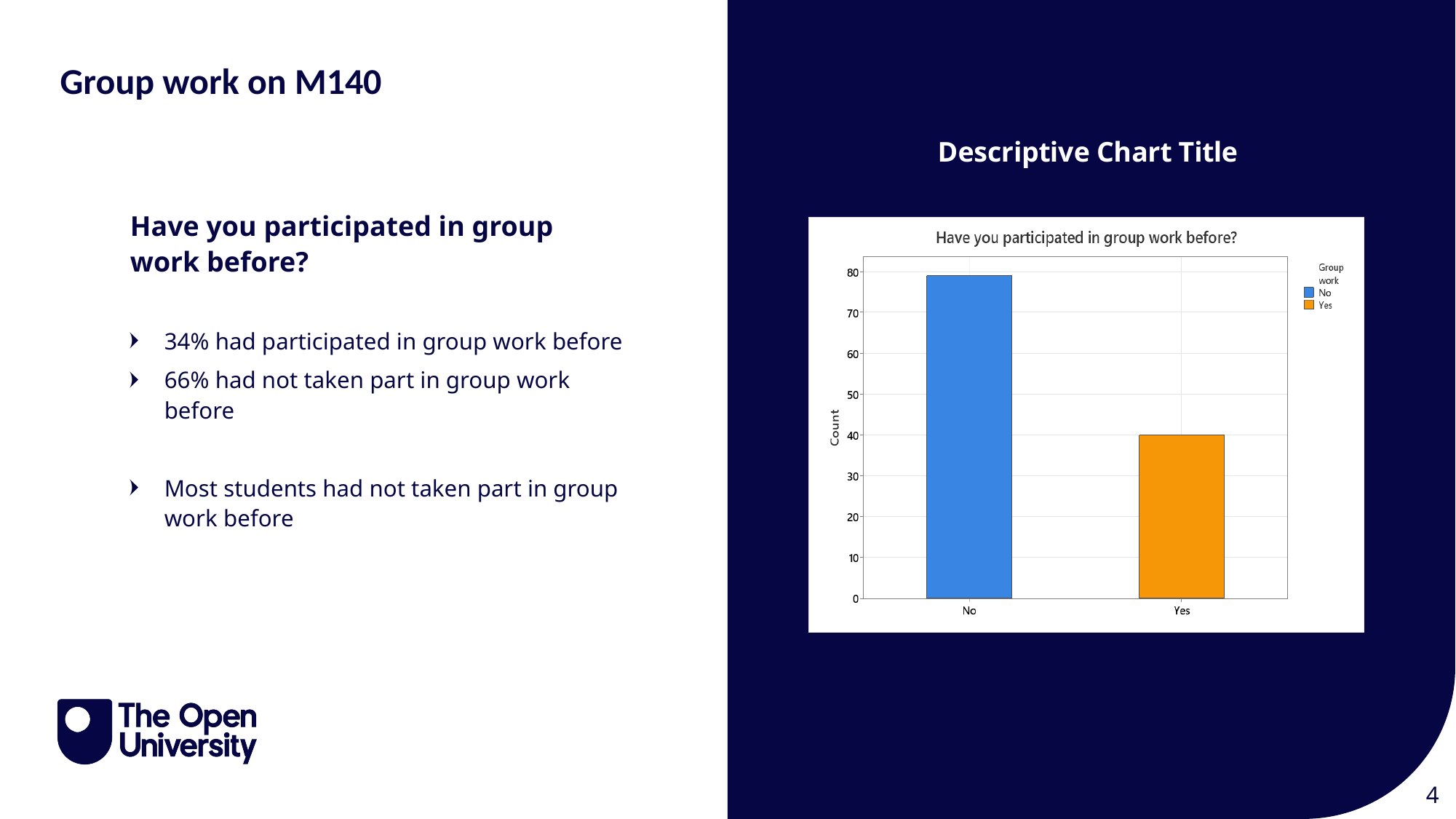
Which is larger in the chart, the count for No or the count for Yes? No Is the count for No greater or less than 70? greater What is the title of the chart? Have you participated in group work before? What is the label on the y axis of the chart? Count What kind of chart is shown on the slide? bar chart Is the count for Yes greater or less than 50? less How many categories are shown on the x axis of the chart? 2 Which category has the lowest count in the chart? Yes Which category has the highest count in the chart? No How many entries does the chart's legend list? 2 What is the count for Yes in the chart? 40